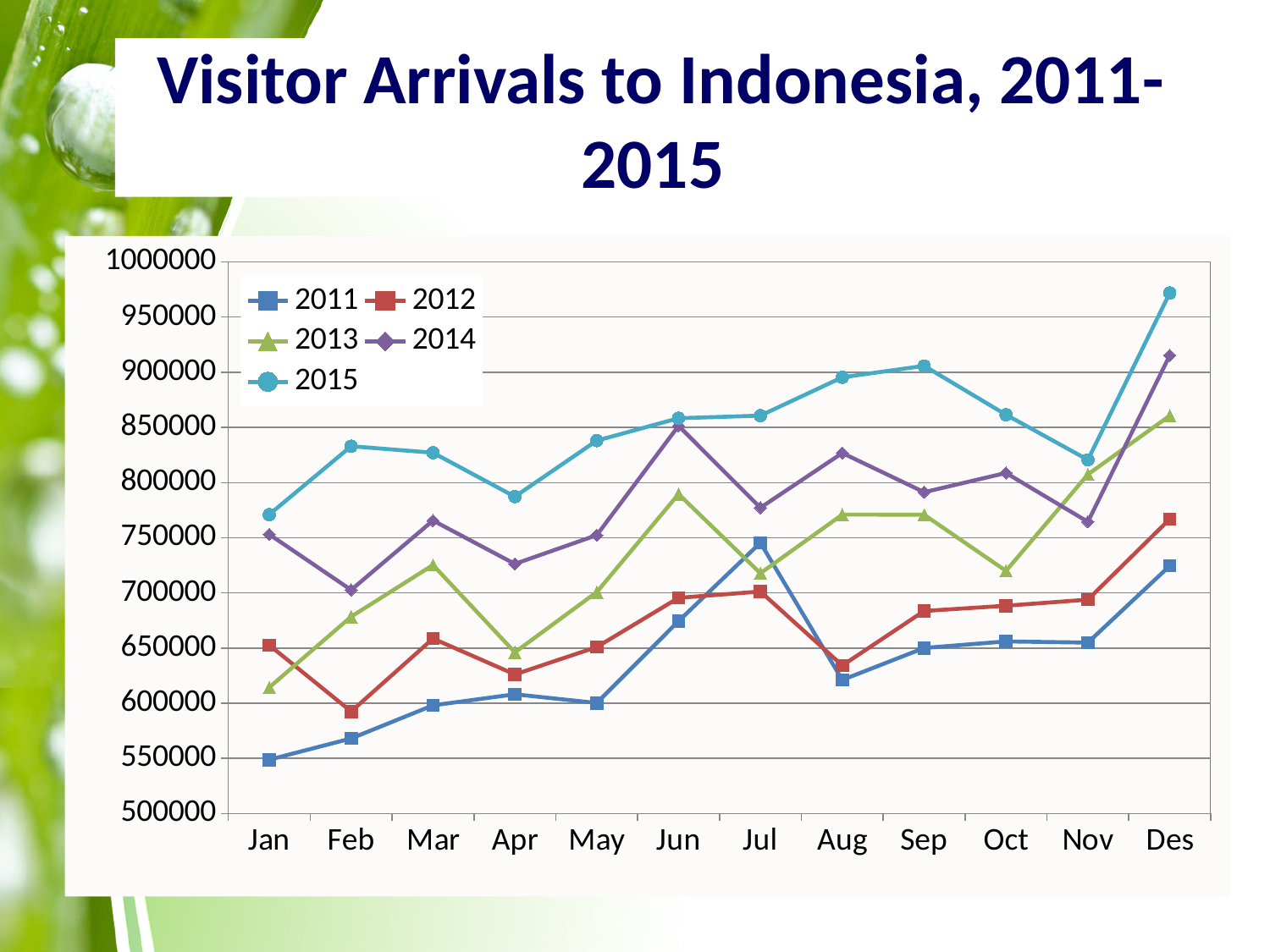
In which month does the 2011 series have its lowest value? Jan In Jul, which series has the higher value, 2011 or 2012? 2011 How many series does the legend list? 5 What kind of chart is shown on the slide? Line chart Is the value for 2015 in Des greater or less than 950000? greater Is the value for 2013 in Jun greater or less than 750000? greater In which month does the 2015 series reach its highest value? Des How many months are shown along the x axis? 12 In which month does the 2012 series have its lowest value? Feb Is the value for 2011 in Jan greater or less than 600000? less Does the 2011 series rise or fall from Jan to Apr? Rise In which month does the 2014 series reach its highest value? Des